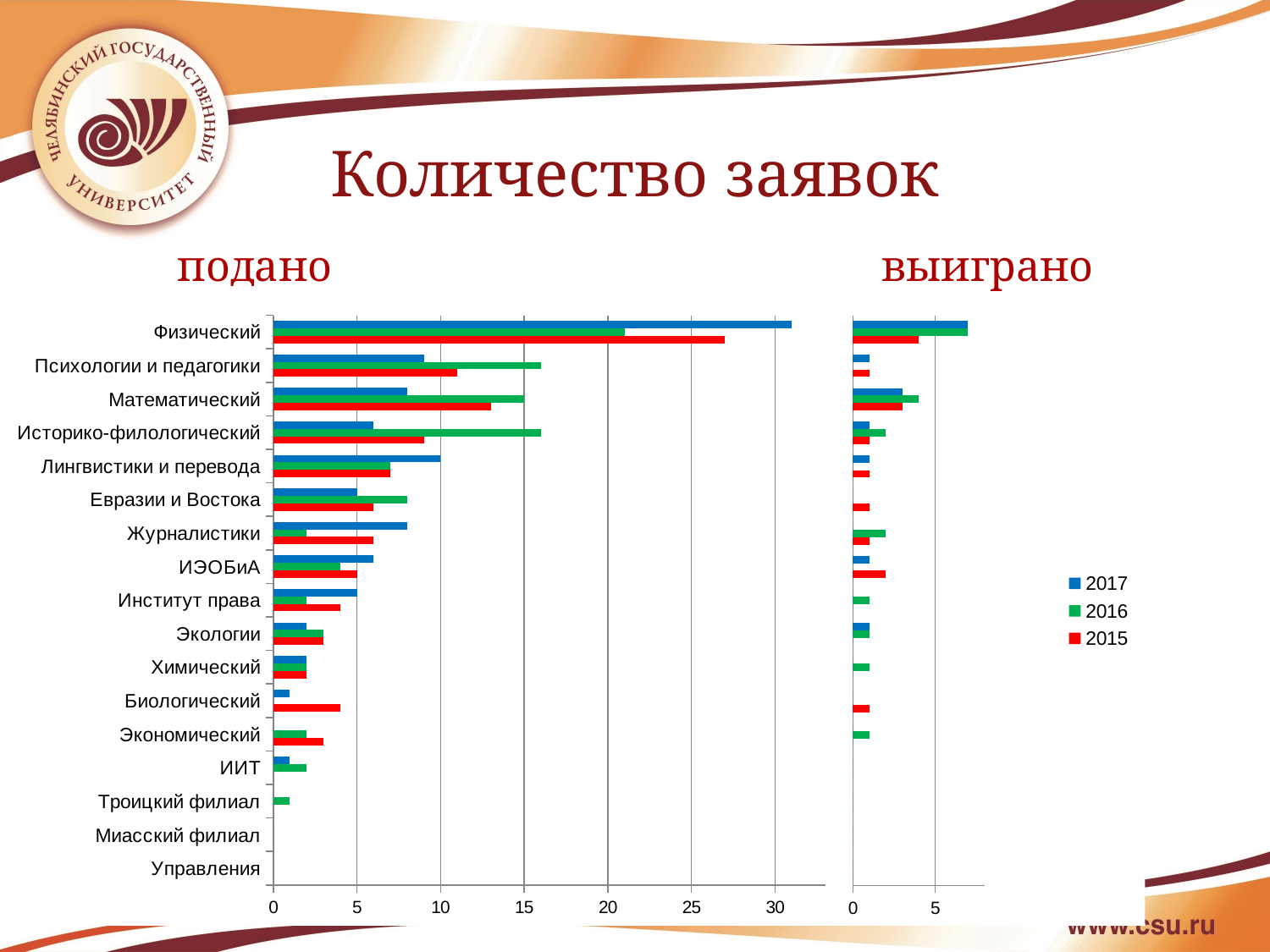
In the "подано" chart, which is larger for Журналистики: the 2017 value or the 2016 value? 2017 In the "подано" chart, is the 2016 value for Психологии и педагогики greater or less than 15? greater In the "подано" chart, which category has the highest value for 2017? Физический What kind of chart is the "подано" chart on the left? bar chart In the "подано" chart, is the 2017 value for Физический greater or less than 30? greater How many categories (faculties) are listed on the "подано" chart? 17 In the "подано" chart, is the 2015 value for Физический greater or less than 25? greater Which years are listed in the legend? 2017, 2016, 2015 In the "подано" chart, which is larger for Биологический: the 2017 value or the 2015 value? 2015 How many series does the legend list? 3 In the "выиграно" chart, which category has the highest value for 2016? Физический